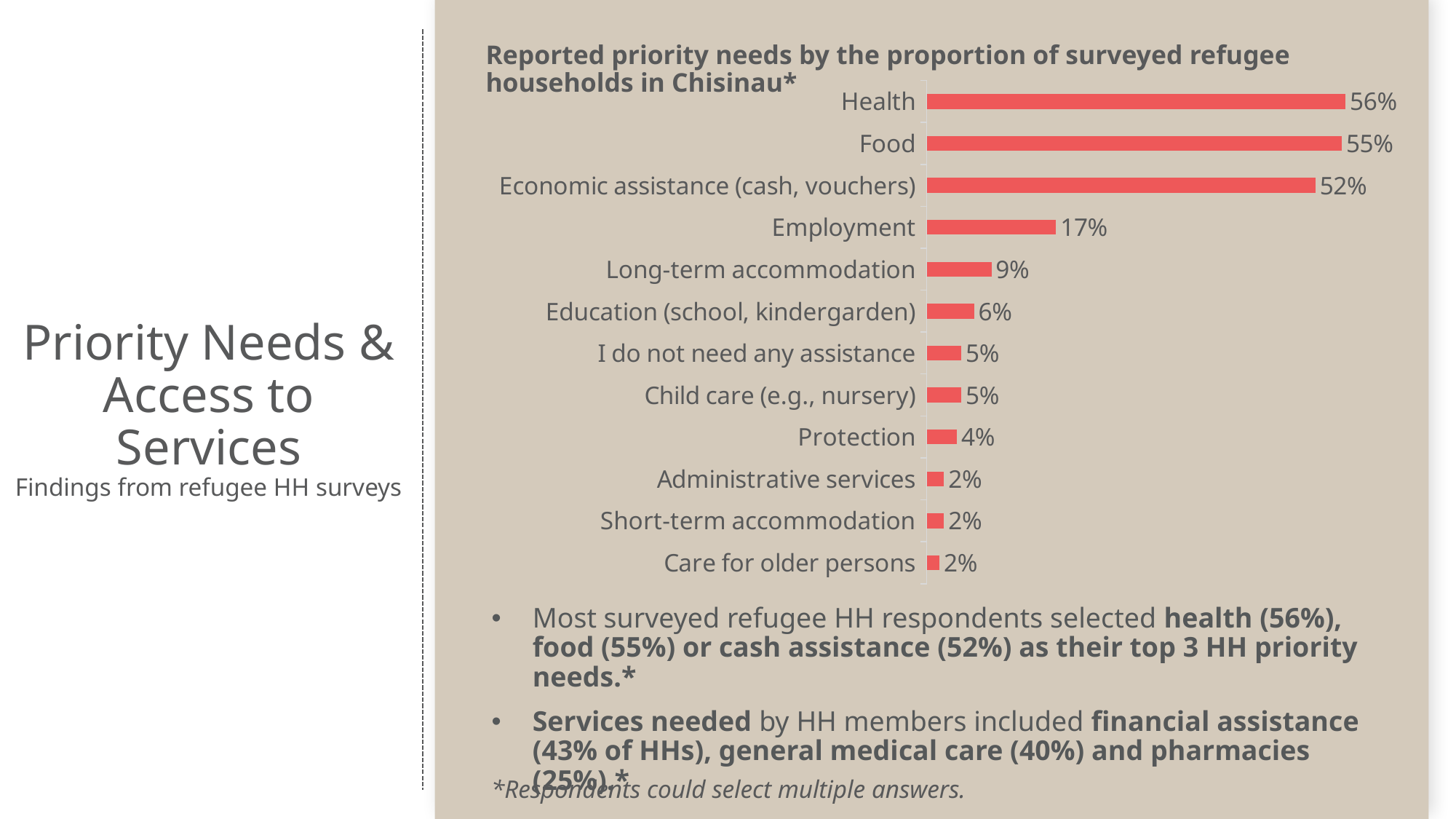
How many categories are shown in the chart? 12 Which is larger, the value for Education (school, kindergarden) or the value for Protection? Education (school, kindergarden) What is the value shown for Employment? 17% What percentage of surveyed refugee households reported Health as a priority need? 56% What is the title of the chart? Reported priority needs by the proportion of surveyed refugee households in Chisinau* What is the difference between the values for Health and Economic assistance (cash, vouchers)? 4% What proportion of households selected Long-term accommodation? 9% What kind of chart is shown on the slide? Bar chart Which is larger, the value for Food or the value for Employment? Food Which priority need has the highest proportion of surveyed households? Health What is the difference between the values for Employment and Long-term accommodation? 8% What colour are the bars in the chart? Red